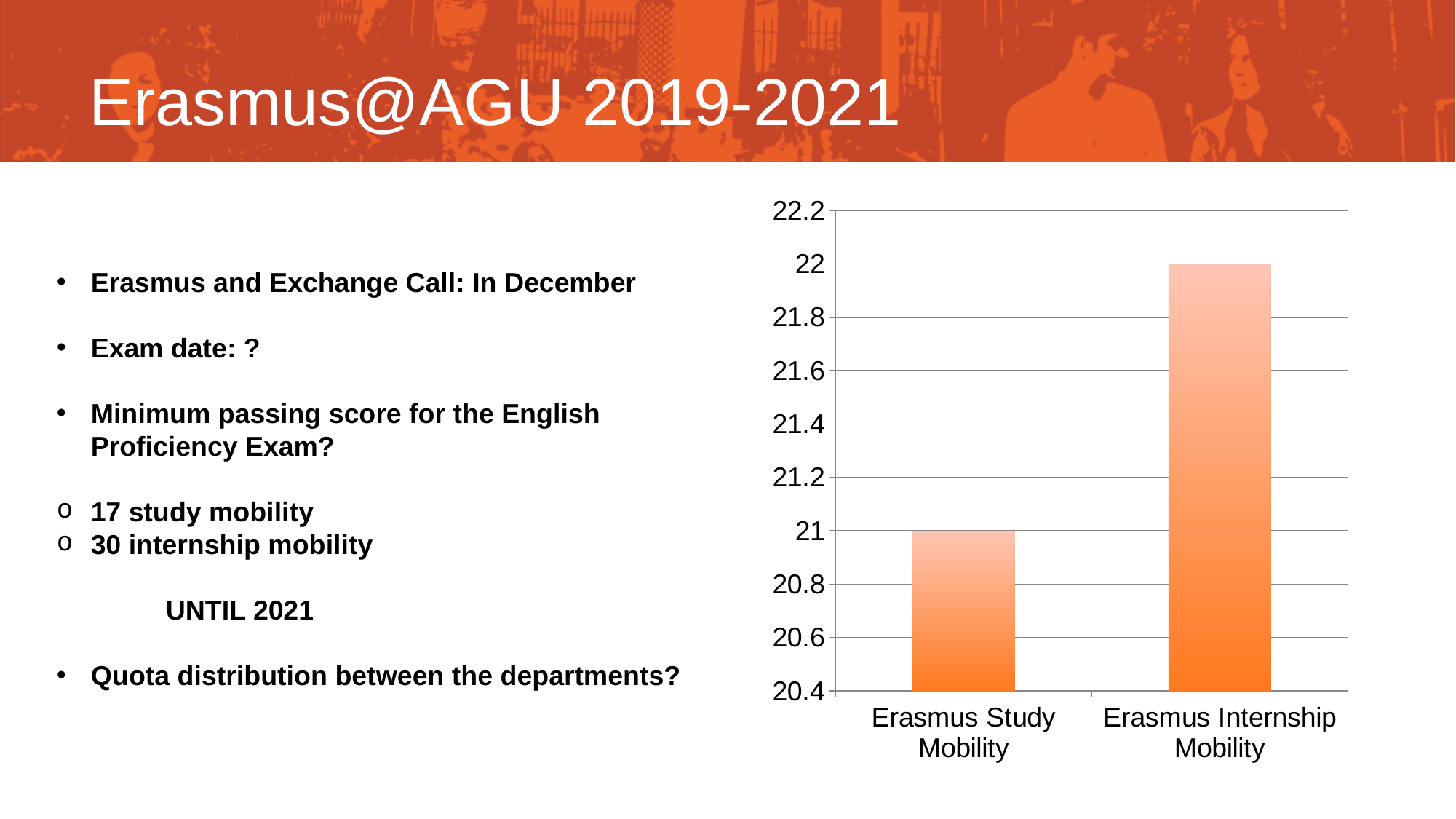
Do the values rise or fall from Erasmus Study Mobility to Erasmus Internship Mobility? rise What kind of chart is shown on the slide? bar chart What is the lowest value shown on the vertical axis of the chart? 20.4 What is the value for Erasmus Internship Mobility? 22 Which is larger, the value for Erasmus Study Mobility or the value for Erasmus Internship Mobility? Erasmus Internship Mobility What is the difference between the values for Erasmus Internship Mobility and Erasmus Study Mobility? 1 Which category has the lowest value? Erasmus Study Mobility How many categories are shown on the chart? 2 What is the value for Erasmus Study Mobility? 21 Which category has the highest value? Erasmus Internship Mobility Is the value for Erasmus Internship Mobility greater or less than 21.4? greater Is the value for Erasmus Study Mobility greater or less than 21.6? less